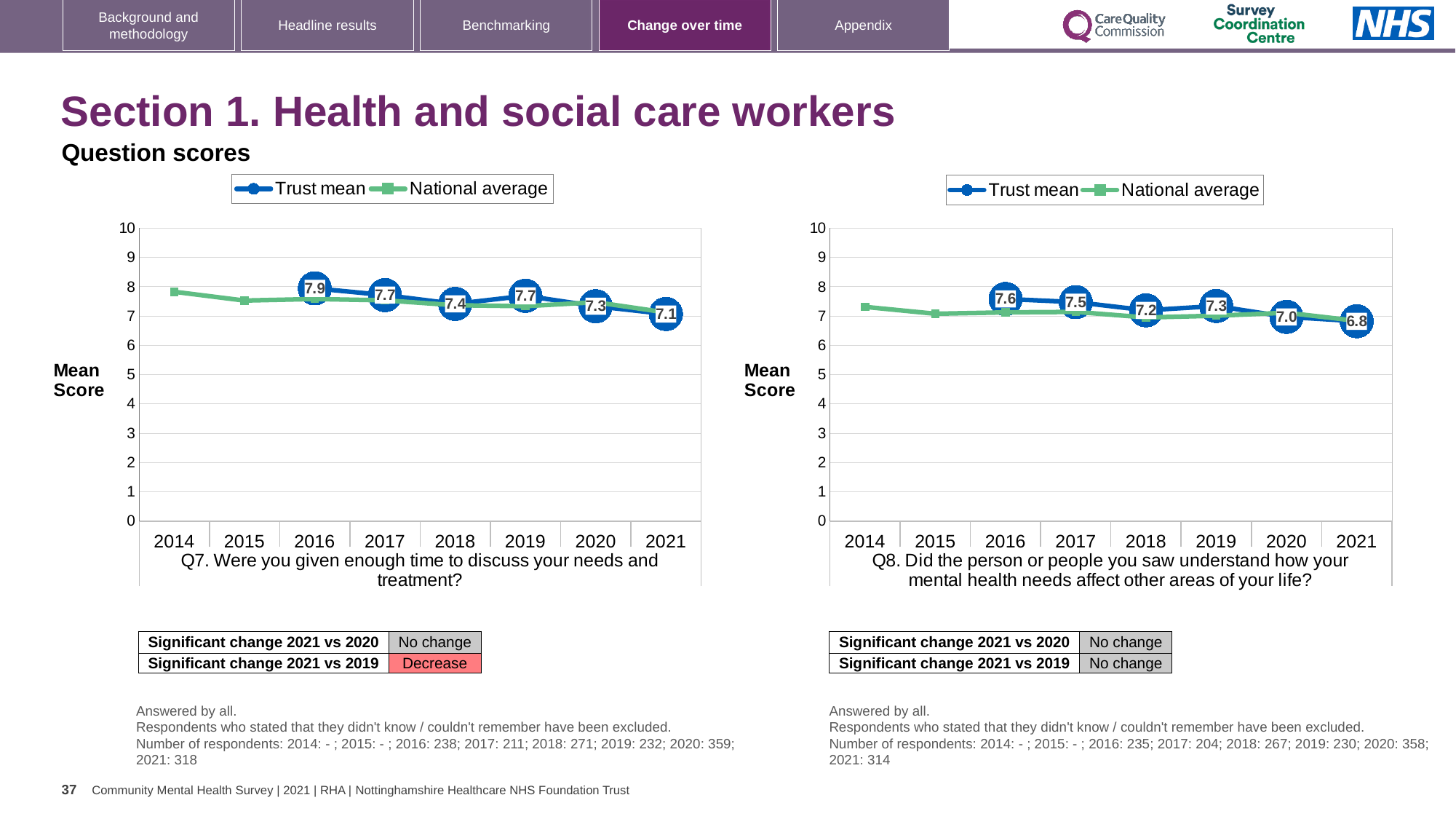
In the Q7 chart (left), what is the Trust mean for 2021? 7.1 In the Q7 chart (left), which year has the highest Trust mean? 2016 How many years are shown on the x axis of the Q8 chart (right)? 8 In the Q8 chart (right), what is the Trust mean for 2018? 7.2 In the Q7 chart (left), what is the difference between the Trust mean in 2016 and in 2021? 0.8 In the Q7 chart (left), is the National average for 2014 greater or less than 7? greater In the Q7 chart (left), what is the Trust mean for 2016? 7.9 In the Q8 chart (right), which is larger, the Trust mean for 2017 or for 2020? 2017 In the Q8 chart (right), what is the Trust mean for 2021? 6.8 How many series does the legend of the Q7 chart (left) list? 2 In the Q8 chart (right), which year has the lowest Trust mean? 2021 What kind of chart is the Q8 chart (right)? Line chart